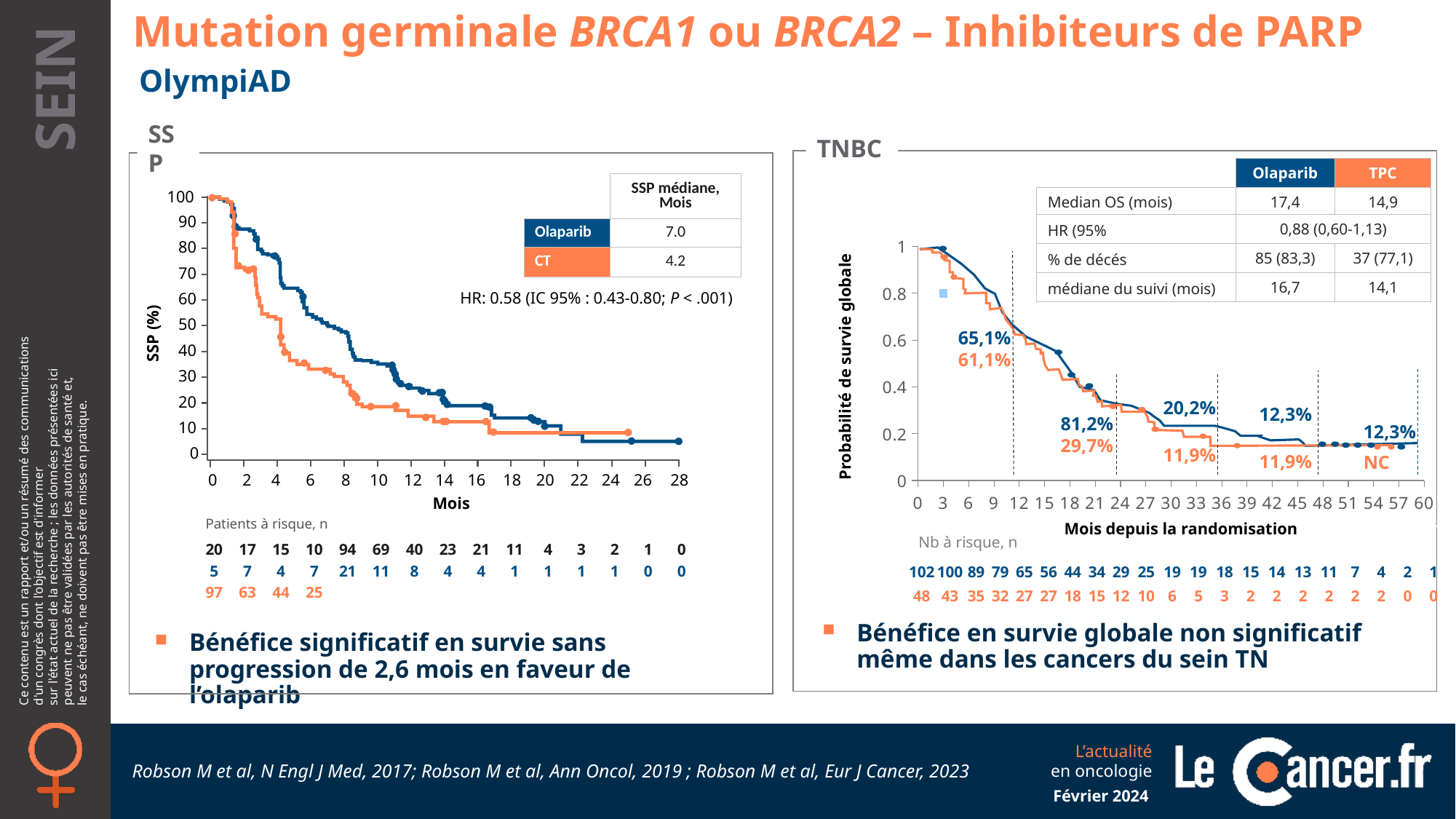
On the SSP chart (left), which arm has the higher median SSP, Olaparib or CT? Olaparib On the SSP chart (left), do the curves rise or fall as months increase? Fall On the TNBC chart (right), what is the label of the x axis? Mois depuis la randomisation On the TNBC chart (right), what is the median OS in months for TPC? 14,9 On the TNBC chart (right), how many Olaparib patients are at risk at month 0? 102 On the SSP chart (left), what is the median SSP in months for Olaparib? 7.0 On the TNBC chart (right), what is the median OS in months for Olaparib? 17,4 On the SSP chart (left), what hazard ratio is reported? 0.58 On the SSP chart (left), what is the median SSP in months for CT? 4.2 On the TNBC chart (right), how many TPC patients are at risk at month 0? 48 On the TNBC chart (right), what is the HR (95%) reported? 0,88 (0,60-1,13) What kind of chart is the SSP chart on the left? Line chart (Kaplan-Meier survival curve)